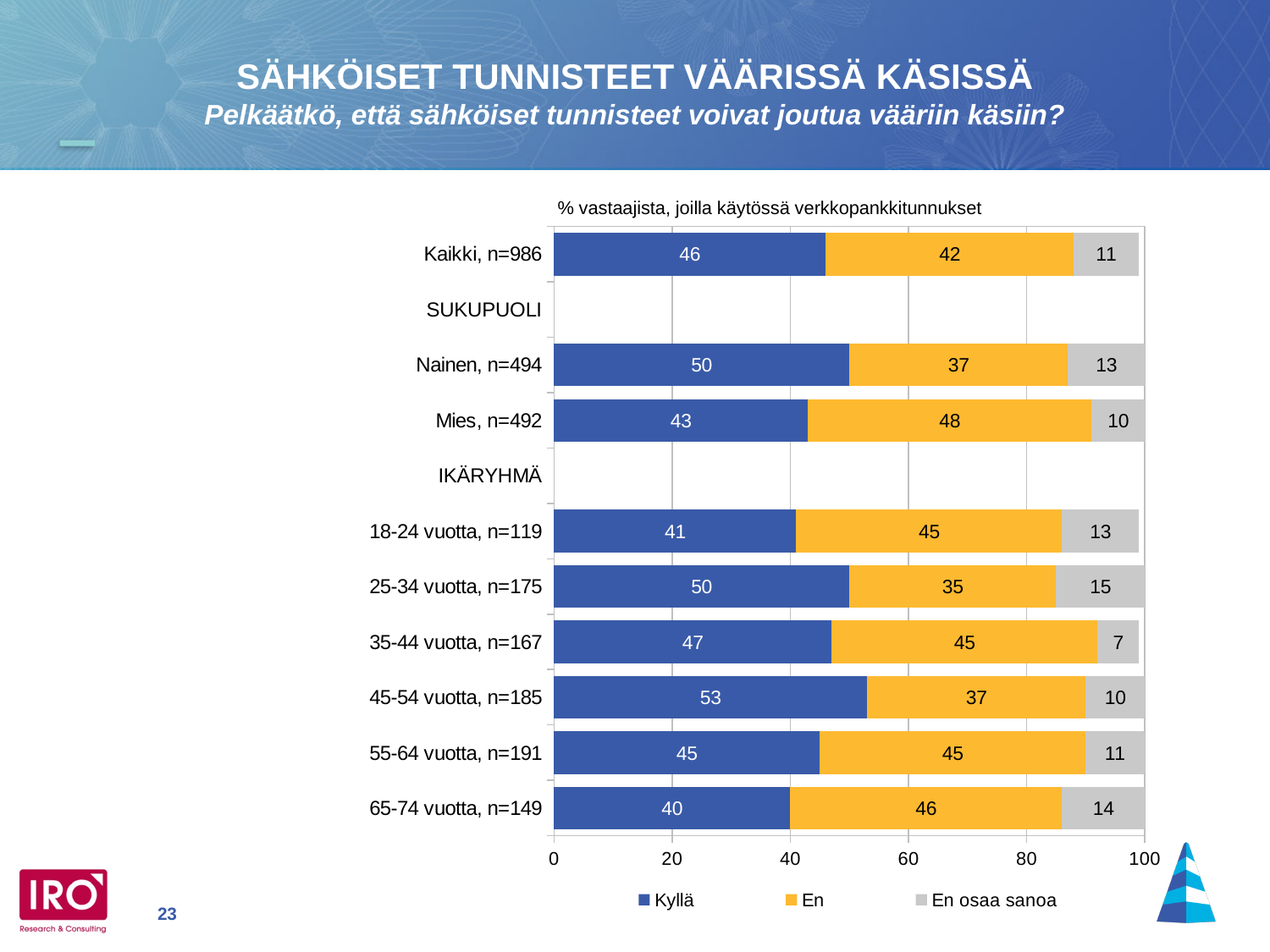
What kind of chart is shown on the slide? Stacked bar chart What is the difference between the Kyllä values for Nainen, n=494 and Mies, n=492? 7 Which category has the highest Kyllä value? 45-54 vuotta, n=185 What is the Kyllä value for 55-64 vuotta, n=191? 45 How many series does the legend list? 3 Which series is shown in yellow? En What is the total of the stacked bar for 65-74 vuotta, n=149? 100 Which is larger, the En value for 18-24 vuotta, n=119 or the En value for 25-34 vuotta, n=175? 18-24 vuotta, n=119 What is the En value for Mies, n=492? 48 Which category has the lowest En osaa sanoa value? 35-44 vuotta, n=167 What is the En osaa sanoa value for 25-34 vuotta, n=175? 15 What is the Kyllä value for Kaikki, n=986? 46